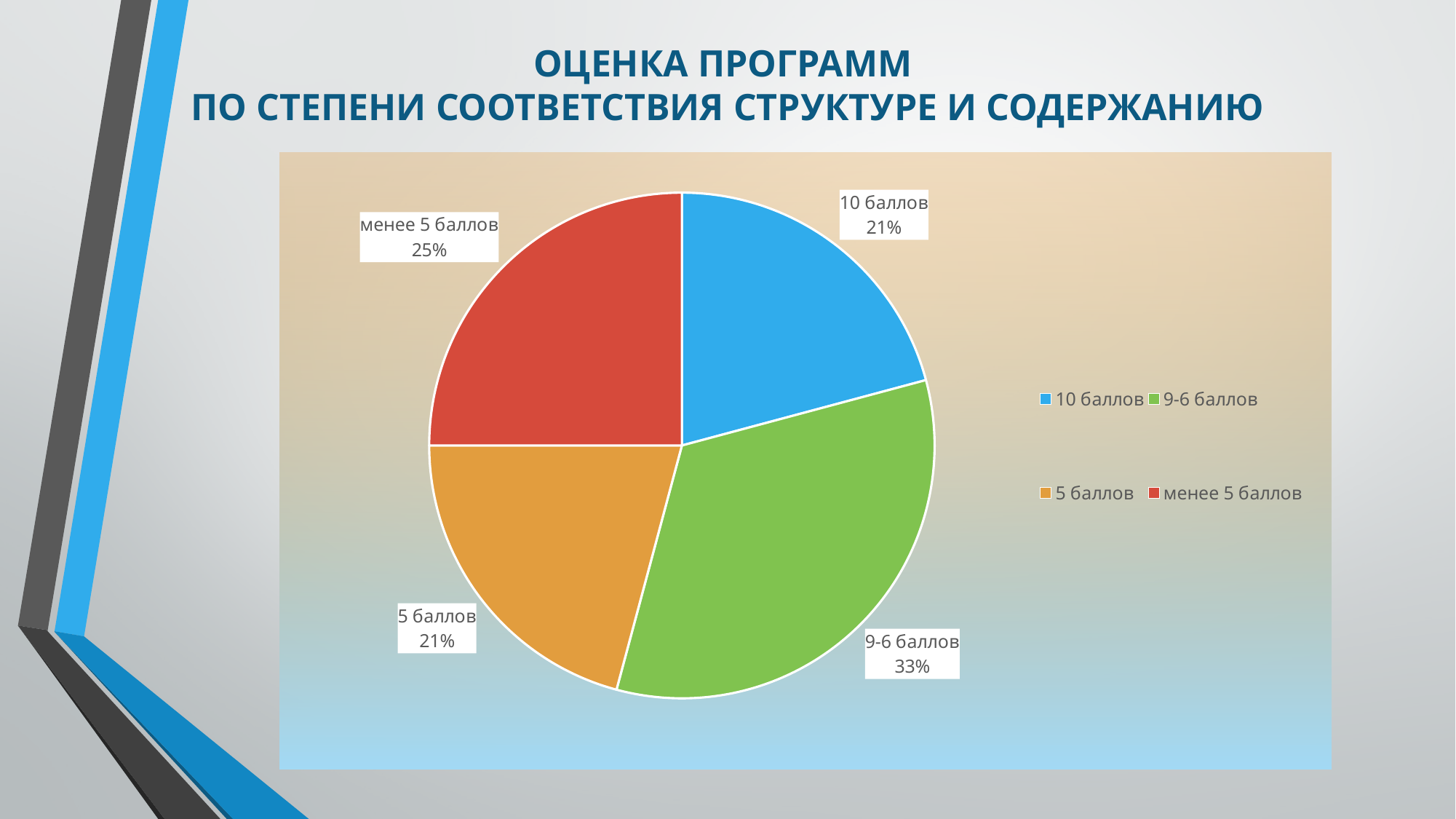
What share of the pie does the "менее 5 баллов" slice represent? 25% What is the value shown for "10 баллов"? 21% How many entries does the legend list? 4 How many slices does the pie chart have? 4 Which category has the largest slice of the pie? 9-6 баллов What share of the pie does the "9-6 баллов" slice represent? 33% What is the value shown for "5 баллов"? 21% What is the difference between the shares of "9-6 баллов" and "менее 5 баллов"? 8% What is the difference between the shares of "менее 5 баллов" and "10 баллов"? 4% Which is larger, the share for "9-6 баллов" or the share for "5 баллов"? 9-6 баллов What type of chart is shown on the slide? pie chart What colour is the "менее 5 баллов" slice? red